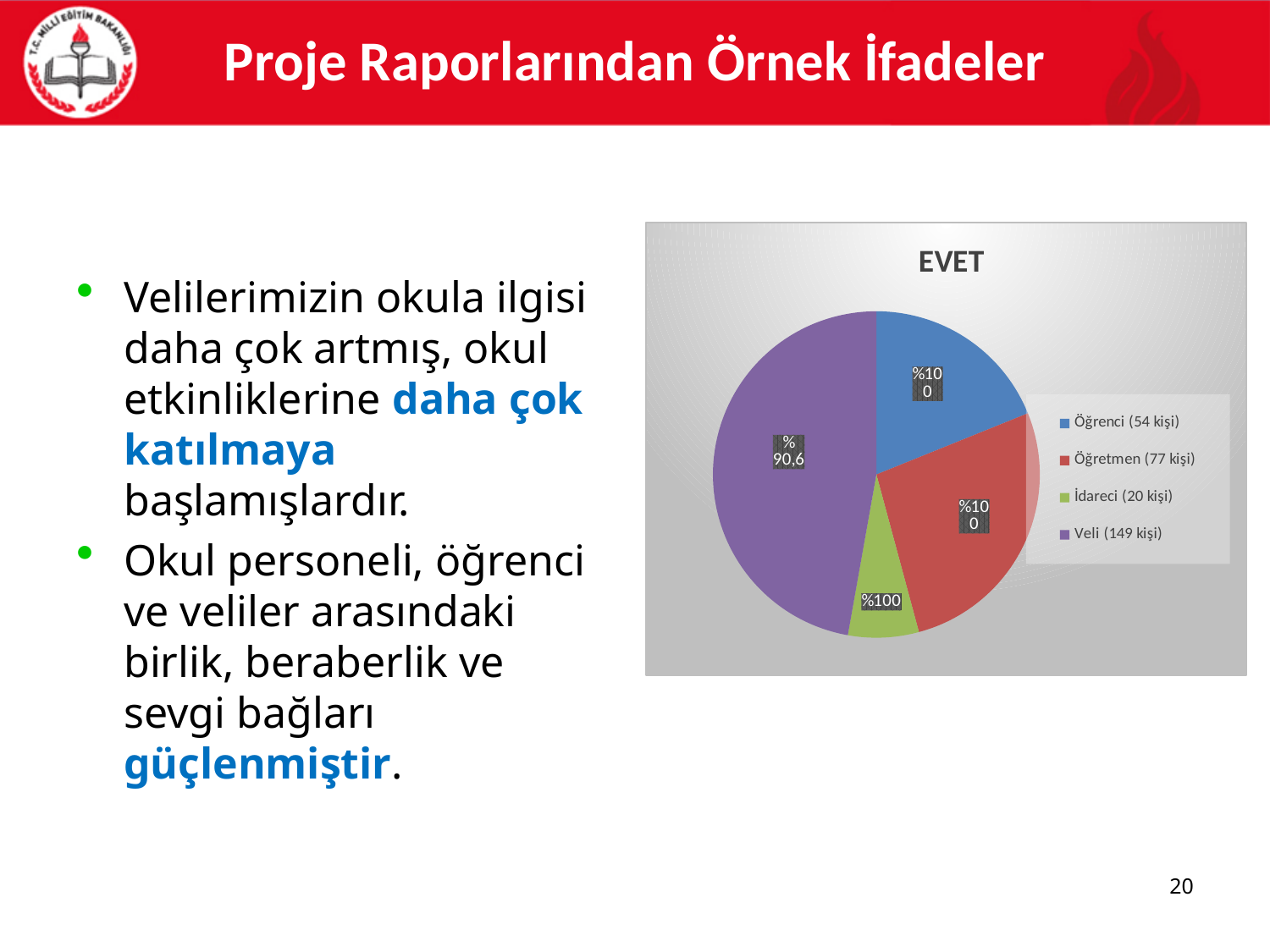
Which category occupies the largest slice of the pie chart? Veli (149 kişi) What is the data label shown on the Öğrenci slice of the pie chart? %100 What kind of chart is shown on the slide? pie chart What colour is the Veli slice in the pie chart? purple What is the title of the pie chart? EVET Which slice has the lowest percentage label in the pie chart? Veli According to the legend, how many more people are in the Veli group than in the Öğrenci group? 95 What is the data label shown on the Veli slice of the pie chart? %90,6 What is the data label shown on the İdareci slice of the pie chart? %100 Which slice is larger in the pie chart, Öğretmen or Öğrenci? Öğretmen Which category occupies the smallest slice of the pie chart? İdareci (20 kişi) How many slices does the pie chart have? 4